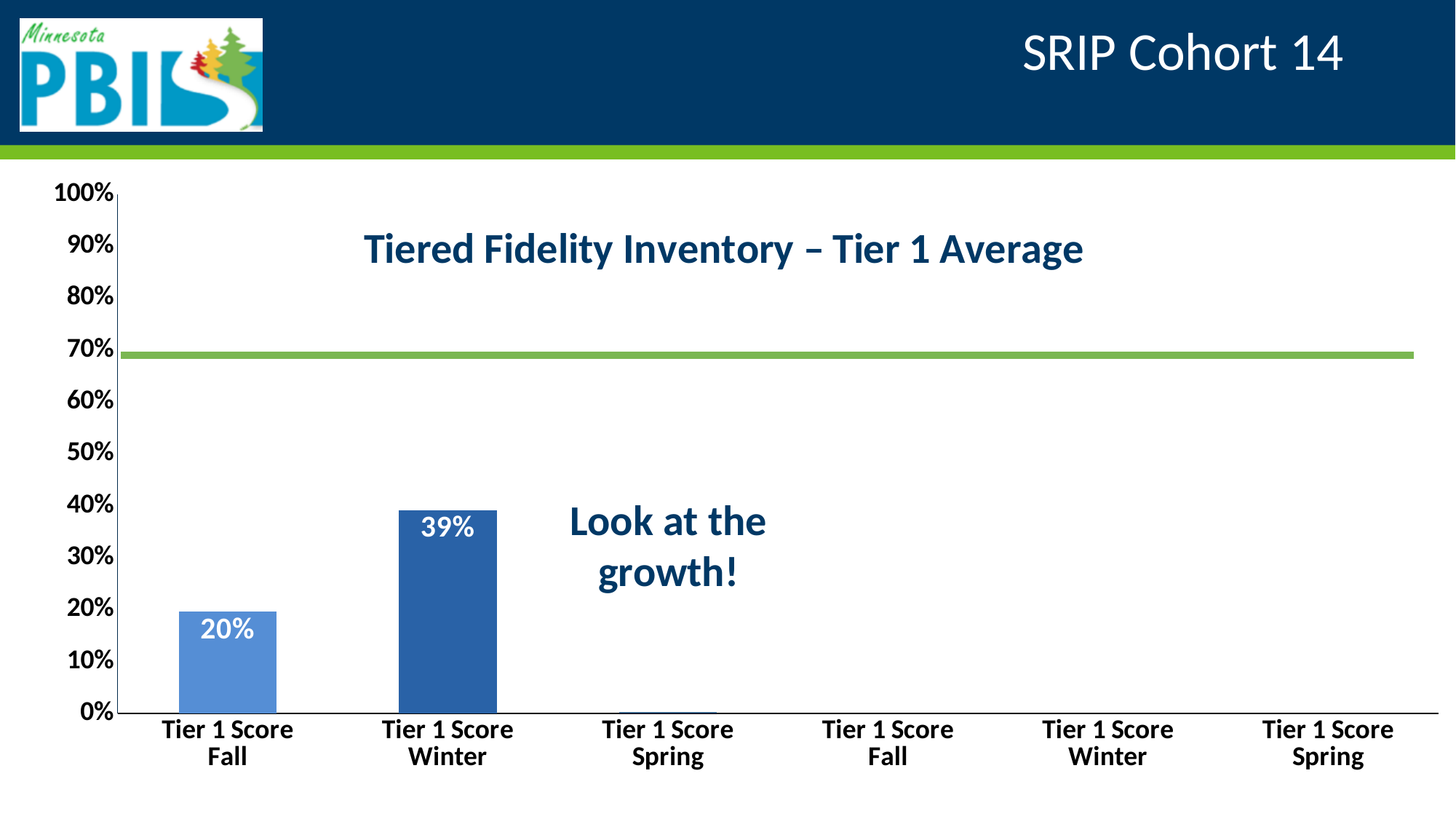
Is the value for the first Tier 1 Score Winter bar greater or less than 30%? greater Does the value rise or fall from the first Tier 1 Score Fall bar to the first Tier 1 Score Winter bar? Rise Which is larger, the first Tier 1 Score Fall value or the first Tier 1 Score Winter value? Tier 1 Score Winter Is the value for the first Tier 1 Score Fall bar greater or less than 30%? less How many bars have a plotted value shown on the chart? 2 What is the value of the first Tier 1 Score Winter bar? 39% How many categories are labelled on the x axis? 6 What is the value of the first Tier 1 Score Fall bar? 20% What is the difference between the first Tier 1 Score Winter value and the first Tier 1 Score Fall value? 19% What is the title of the chart? Tiered Fidelity Inventory – Tier 1 Average Which category has the highest plotted value? Tier 1 Score Winter (the first one) What kind of chart is shown on the slide? Bar chart